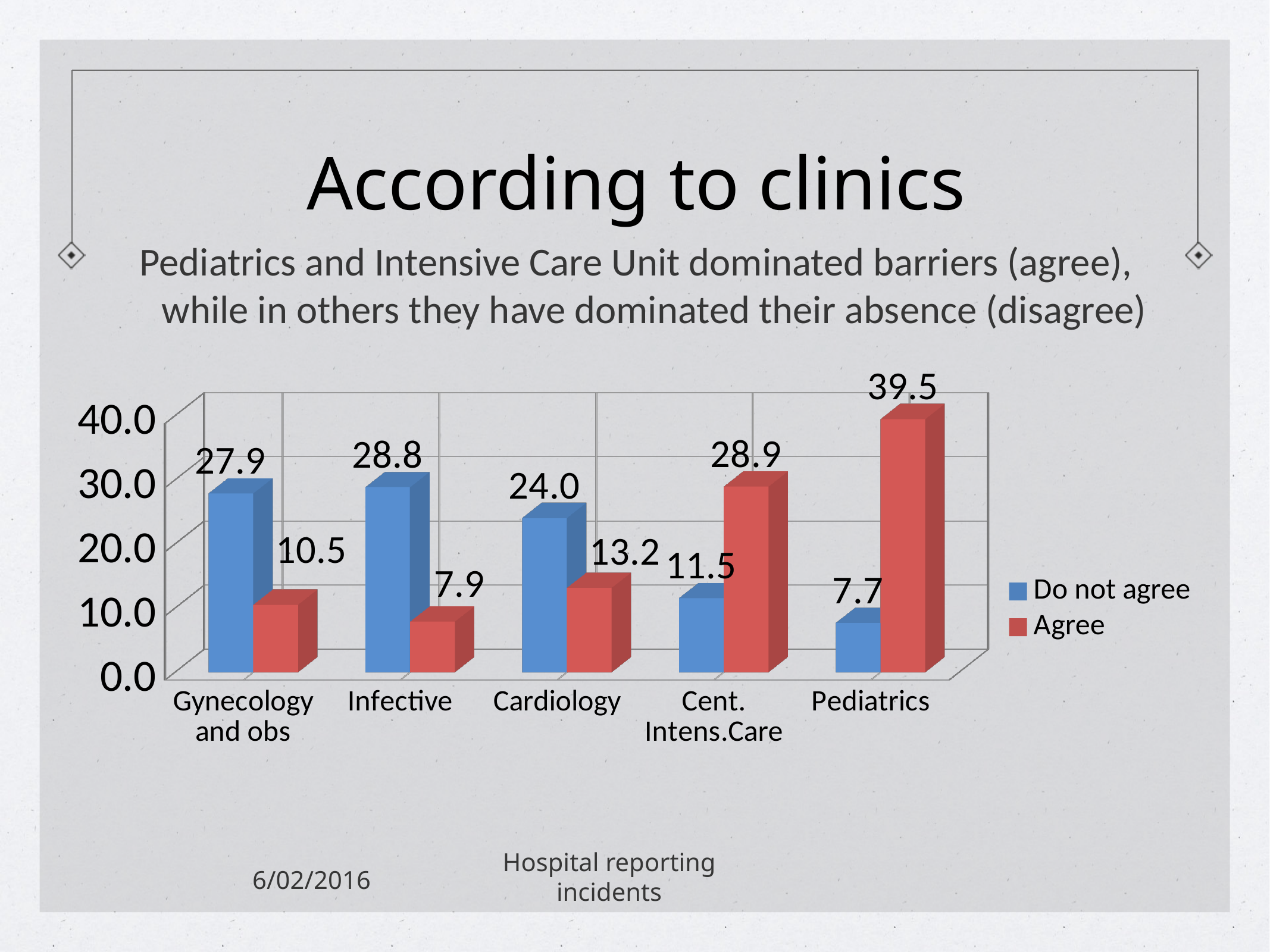
What is the "Do not agree" value for Cent. Intens.Care? 11.5 Which clinic has the lowest "Do not agree" value? Pediatrics What is the "Do not agree" value for Infective? 28.8 For Gynecology and obs, which is larger: "Do not agree" or "Agree"? Do not agree Which clinic has the lowest "Agree" value? Infective What kind of chart is shown on the slide? Bar chart How many clinics are shown on the x axis? 5 What is the "Agree" value for Pediatrics? 39.5 What is the difference between the "Agree" and "Do not agree" values for Pediatrics? 31.8 How many series does the legend list? 2 Which clinic has the highest "Agree" value? Pediatrics What is the "Agree" value for Cardiology? 13.2